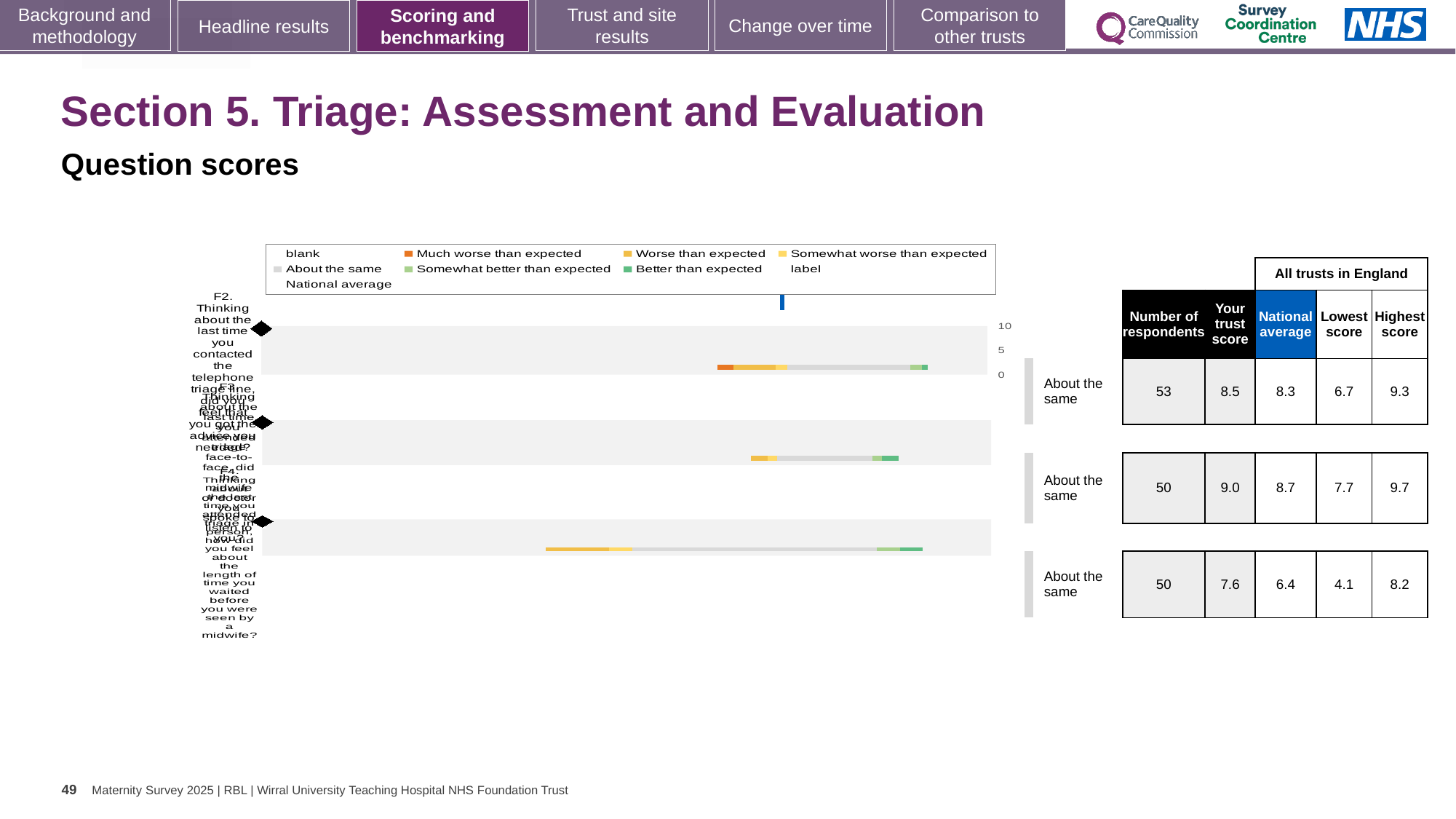
For the first (top) question row, what is the difference between 'Your trust score' and the National average? 0.2 How many question rows (bars) are plotted in the chart? 3 What benchmark label is shown next to each of the three question rows? About the same What is the National average for the first (top) question row? 8.3 What is the Lowest score for the third (bottom) question row? 4.1 What is the 'Your trust score' value for the first (top) question row? 8.5 Which question row has the highest 'Your trust score'? the second row (9.0) Which question row has the lowest 'Your trust score'? the third row (7.6) For the third (bottom) question row, what is the difference between the Highest score and the Lowest score? 4.1 What kind of chart is shown on the slide? bar chart How many respondents are listed for the second question row? 50 For the third (bottom) question row, which is larger: 'Your trust score' or the National average? Your trust score